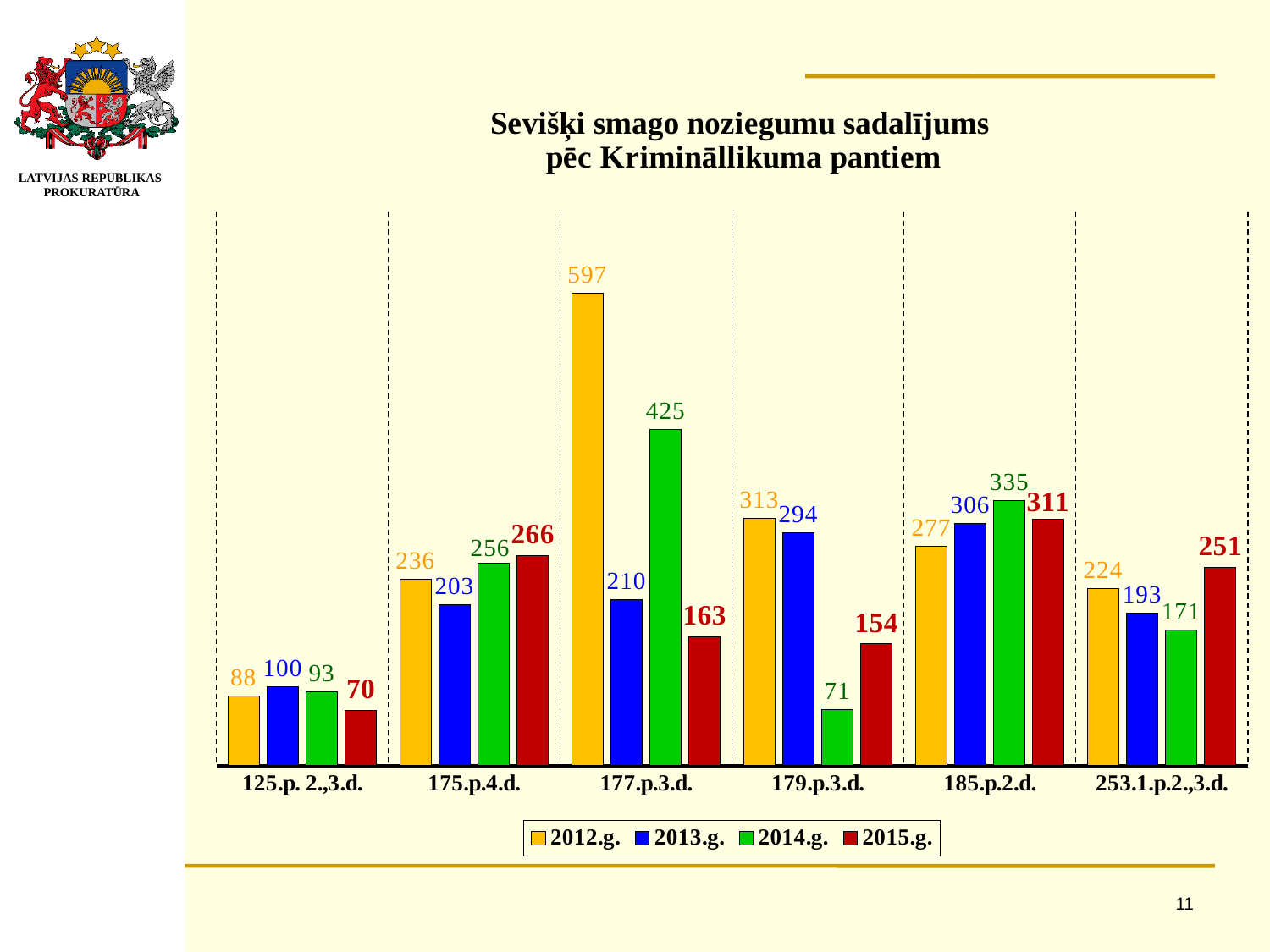
Which category has the highest value for 2013.g.? 185.p.2.d. What is the value for 2014.g. in the category 179.p.3.d.? 71 How many series does the legend list? 4 What is the value for 2015.g. in the category 253.1.p.2.,3.d.? 251 Do the values for 2015.g. rise or fall from 185.p.2.d. to 253.1.p.2.,3.d.? fall Which category has the lowest value for 2015.g.? 125.p. 2.,3.d. What is the difference between the 2012.g. and 2014.g. values in the category 177.p.3.d.? 172 How many categories are shown on the x axis? 6 What is the value for 2012.g. in the category 177.p.3.d.? 597 What is the title of the chart? Sevišķi smago noziegumu sadalījums pēc Krimināllikuma pantiem What kind of chart is shown on the slide? bar chart Which is larger in the category 175.p.4.d.: the value for 2013.g. or the value for 2015.g.? 2015.g.